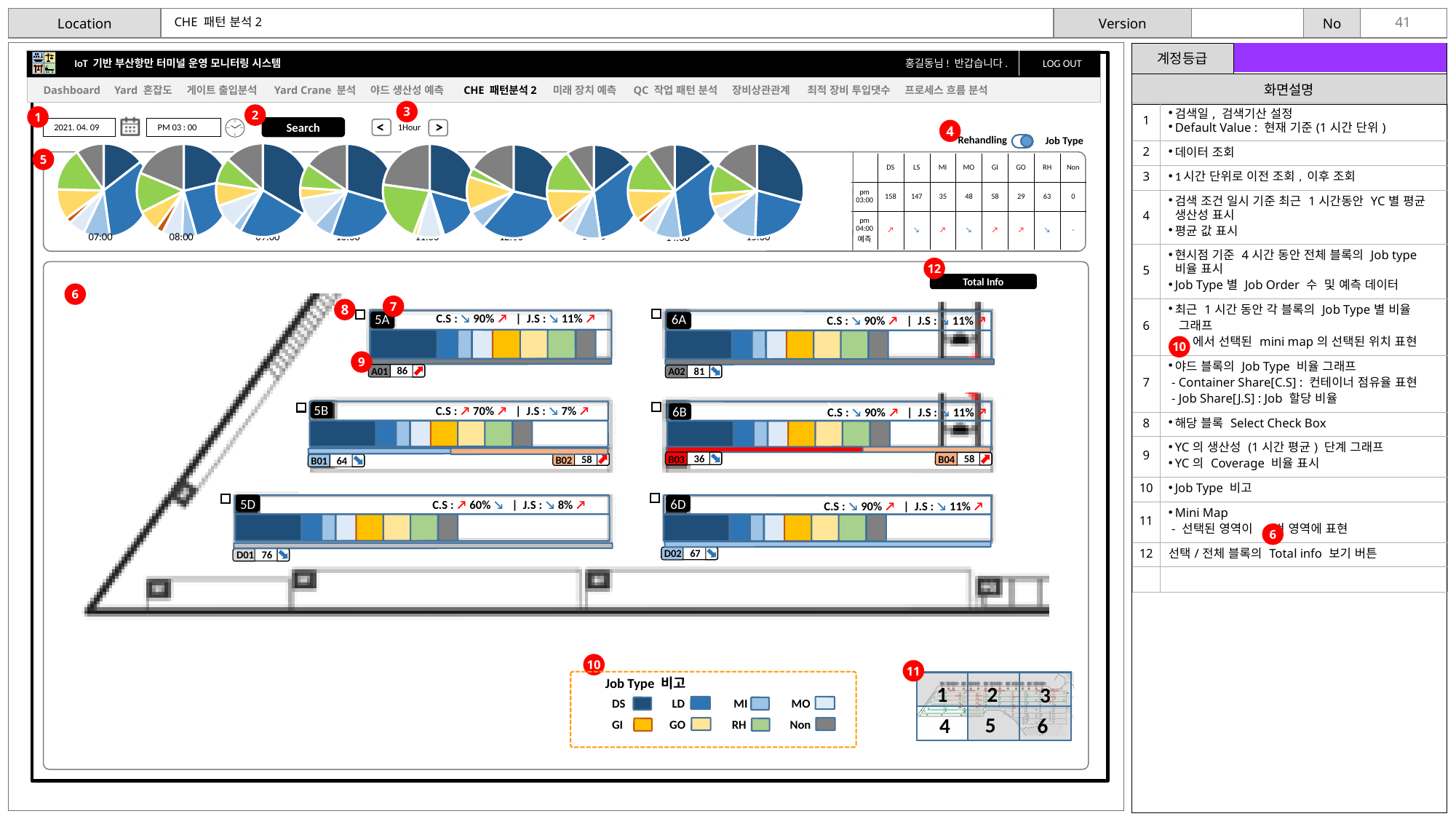
In the table next to the pie charts, what is the difference between the DS and LS values at pm 03:00? 11 How many job types does the 'Job Type 비고' legend list? 8 What kind of chart is used inside each block panel (5A, 5B, 5D, 6A, 6B, 6D) to show the job type ratio? bar chart What is the J.S value shown for block 5D? 8% In the table next to the pie charts, which job type has the highest value at pm 03:00? DS What is the C.S value shown for block 5B? 70% What kind of charts are shown in the row of time-labelled charts at the top of the screen (07:00 to 15:00)? pie charts In the table next to the pie charts, what is the value for DS at pm 03:00? 158 In the table next to the pie charts, what is the value for RH at pm 03:00? 63 In the table next to the pie charts, which job type has the lowest value at pm 03:00? Non How many pie charts are shown in the row at the top of the screen? 9 Which block has the larger C.S value, 5A or 5D? 5A